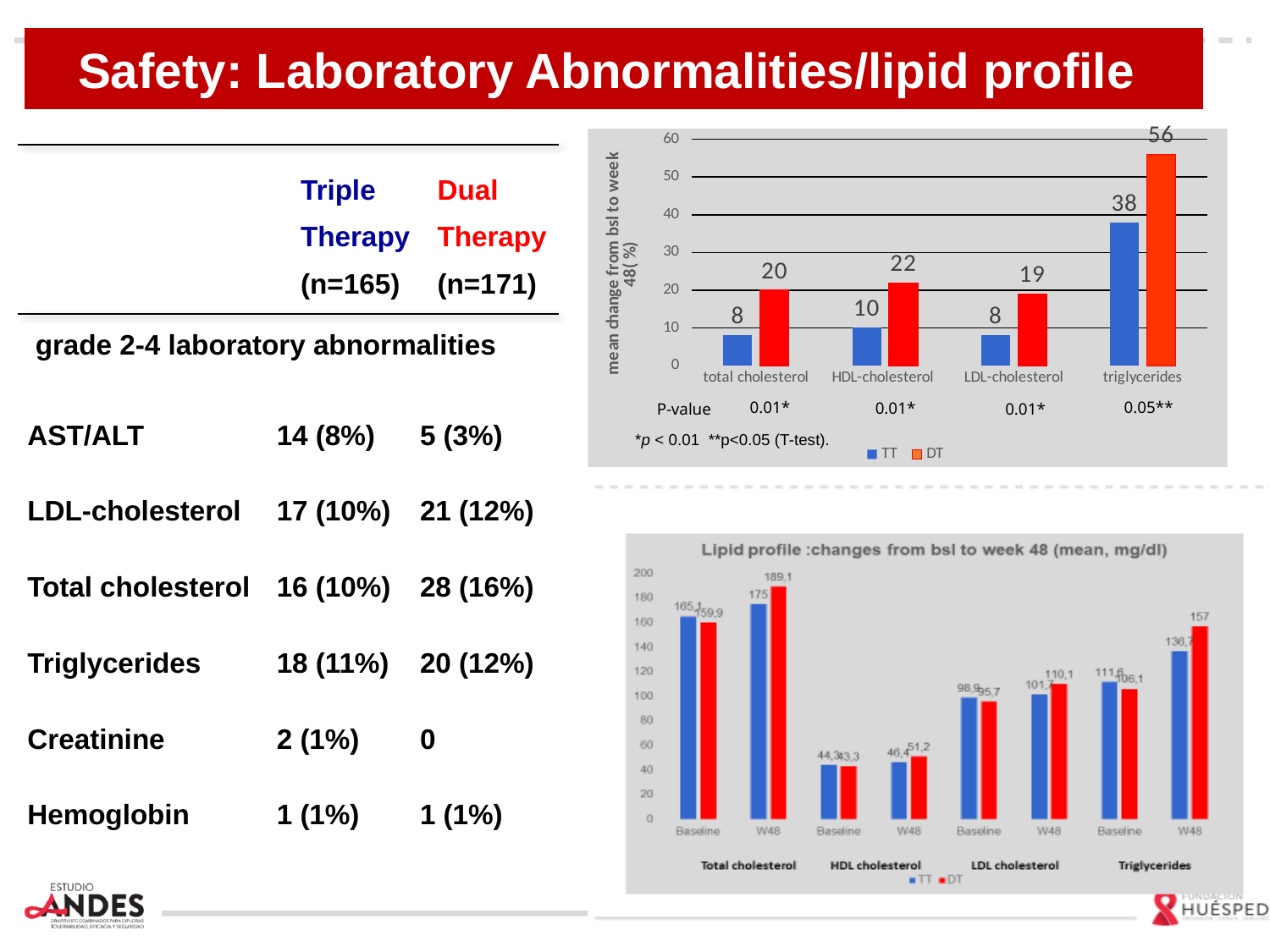
In the top chart (mean change from bsl to week 48, %), how many categories are shown on the x axis? 4 In the top chart (mean change from bsl to week 48, %), what is the DT value for triglycerides? 56 In the top chart (mean change from bsl to week 48, %), what is the DT value for LDL-cholesterol? 19 In the top chart (mean change from bsl to week 48, %), which is larger for HDL-cholesterol, the TT value or the DT value? DT In the top chart (mean change from bsl to week 48, %), what P-value is shown for triglycerides? 0.05** In the top chart (mean change from bsl to week 48, %), what is the difference between the DT and TT values for total cholesterol? 12 In the bottom chart titled 'Lipid profile: changes from bsl to week 48 (mean, mg/dl)', what is the DT value at W48 for total cholesterol? 189,1 In the top chart (mean change from bsl to week 48, %), how many series does the legend list? 2 What kind of chart is the bottom chart titled 'Lipid profile: changes from bsl to week 48 (mean, mg/dl)'? bar chart In the bottom chart titled 'Lipid profile: changes from bsl to week 48 (mean, mg/dl)', what is the DT value at W48 for triglycerides? 157 In the top chart (mean change from bsl to week 48, %), what is the TT value for HDL-cholesterol? 10 In the top chart (mean change from bsl to week 48, %), which category has the highest TT value? triglycerides